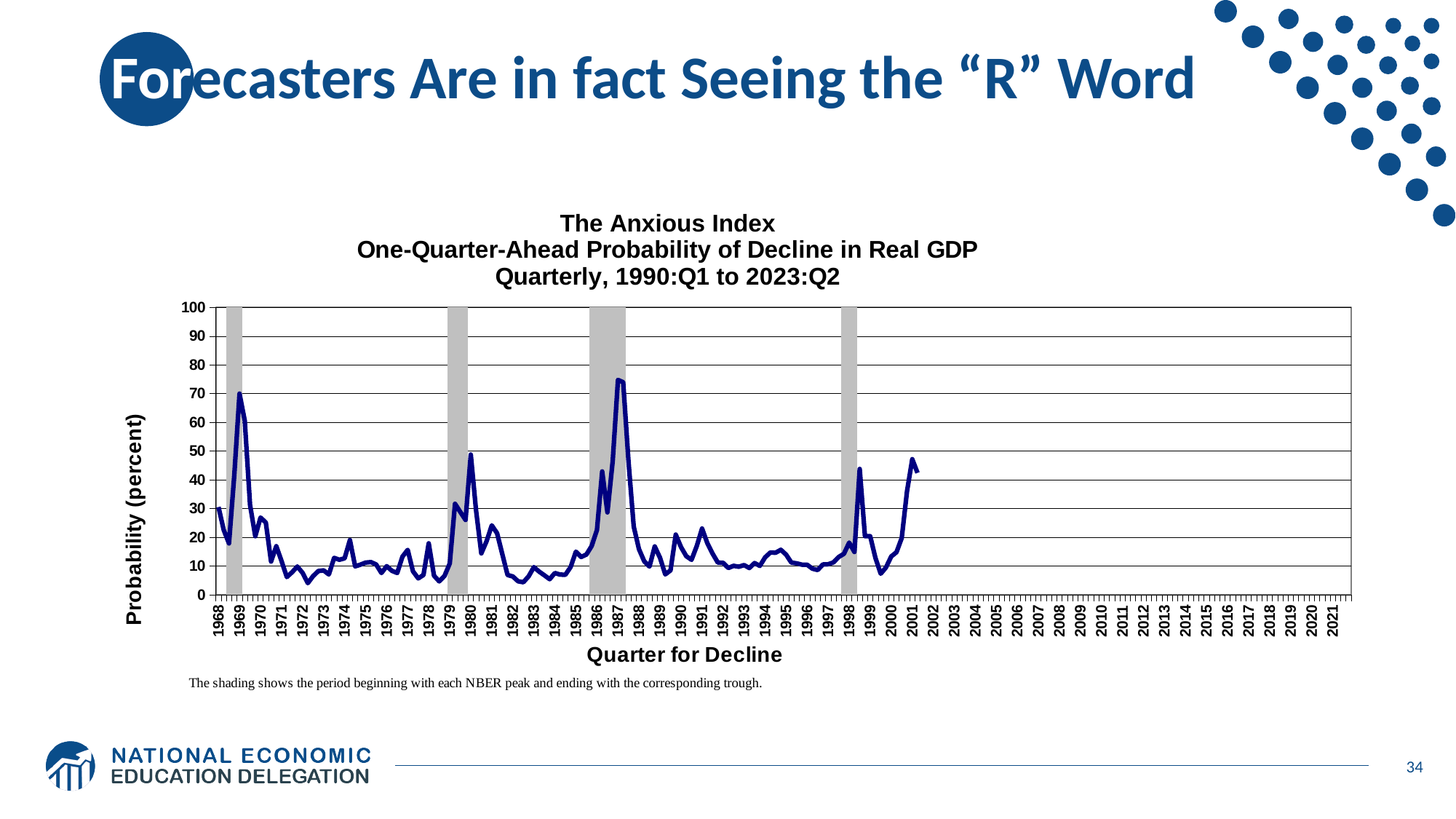
What kind of chart is shown on the slide? line chart Is the peak around 1987 higher or lower than the peak around 1980? higher Is the final value of the line, around 2001, greater or less than 30? greater Is the value of the line around 1972 greater or less than 10? less Is the peak value of the line around 1980 greater or less than 40? greater Does the line rise or fall between its peak around 1987 and 1988? fall Around which year on the x-axis does the line reach its highest peak? 1987 What is the title of the x-axis on the chart? Quarter for Decline What is the title of the y-axis on the chart? Probability (percent)